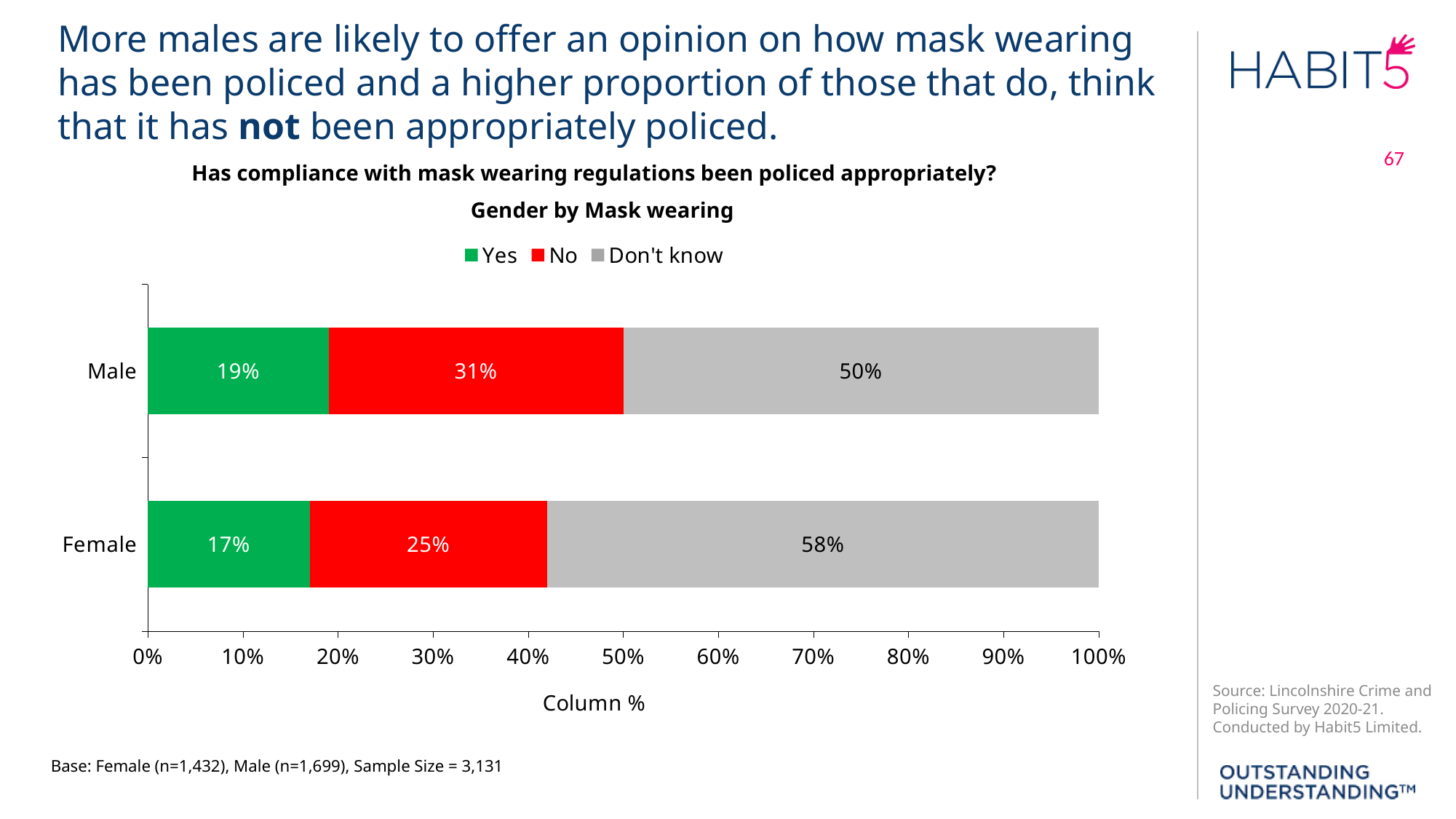
What percentage of males answered "Don't know"? 50% Which gender has the higher "Don't know" percentage? Female What percentage of males answered "No"? 31% What percentage of females answered "Don't know"? 58% What type of chart is shown? Stacked bar chart What is the difference between the "No" percentages for males and females? 6% Which response category is the smallest for females? Yes How many series does the legend list? 3 What is the difference between the "Yes" percentages for males and females? 2% Which response category is the largest for males? Don't know How many gender categories are shown on the chart? 2 What percentage of females answered "Yes"? 17%